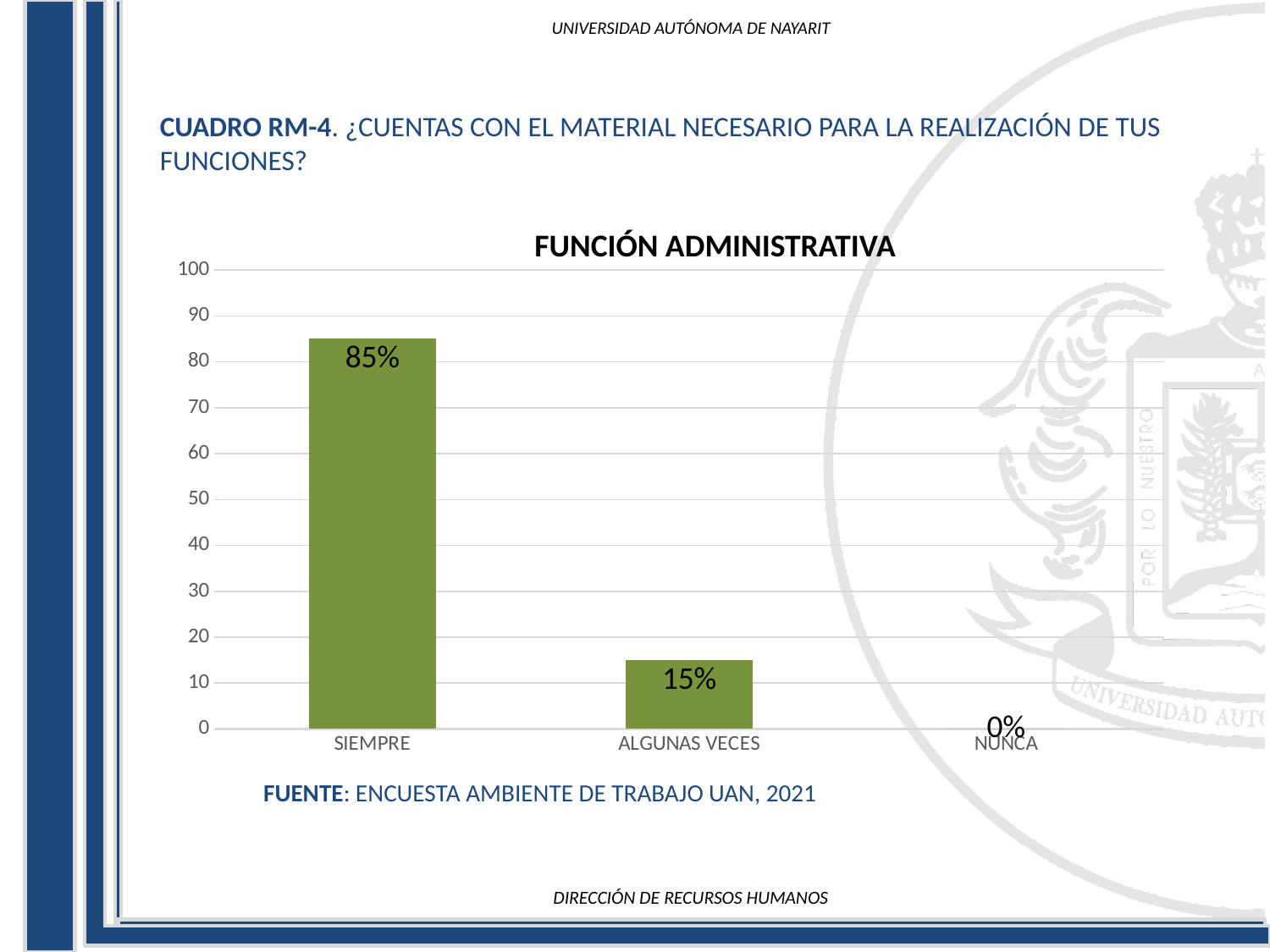
What is the title of the chart? FUNCIÓN ADMINISTRATIVA What is the value for SIEMPRE? 85% Which category has the highest value? SIEMPRE Which is larger, the value for SIEMPRE or the value for ALGUNAS VECES? SIEMPRE How many categories are shown on the x axis? 3 What is the value for NUNCA? 0% What kind of chart is shown? bar chart Is the value for ALGUNAS VECES greater or less than 20? less What is the value for ALGUNAS VECES? 15% Which category has the lowest value? NUNCA What is the difference between the values for SIEMPRE and ALGUNAS VECES? 70% Is the value for SIEMPRE greater or less than 80? greater